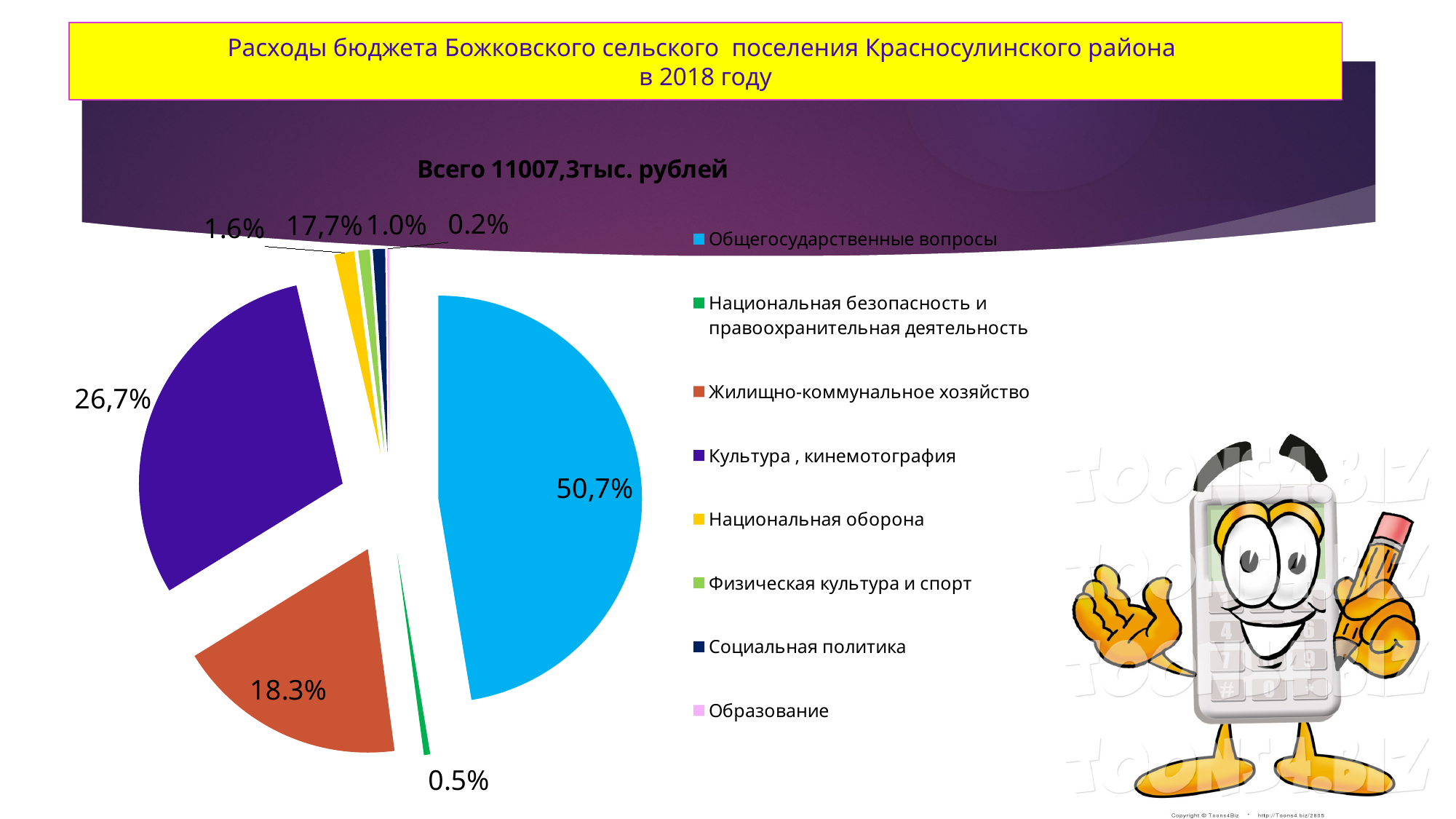
Which category has the largest slice of the pie? Общегосударственные вопросы Which is larger: the share for Культура, кинемотография or for Жилищно-коммунальное хозяйство? Культура, кинемотография Which colour represents Национальная оборона in the legend? Yellow Is the share for Общегосударственные вопросы greater or less than 50%? greater What total amount of expenditure is stated above the pie chart? 11007,3 тыс. рублей What percentage is shown for Жилищно-коммунальное хозяйство? 18.3% How many categories does the legend of the pie chart list? 8 What share of the pie is labelled for Культура, кинемотография? 26,7% By how many percentage points does the share for Общегосударственные вопросы exceed the share for Культура, кинемотография? 24% What share of the budget expenditure goes to Общегосударственные вопросы? 50,7% What kind of chart is shown on the slide? Pie chart What percentage is shown for Национальная безопасность и правоохранительная деятельность? 0.5%